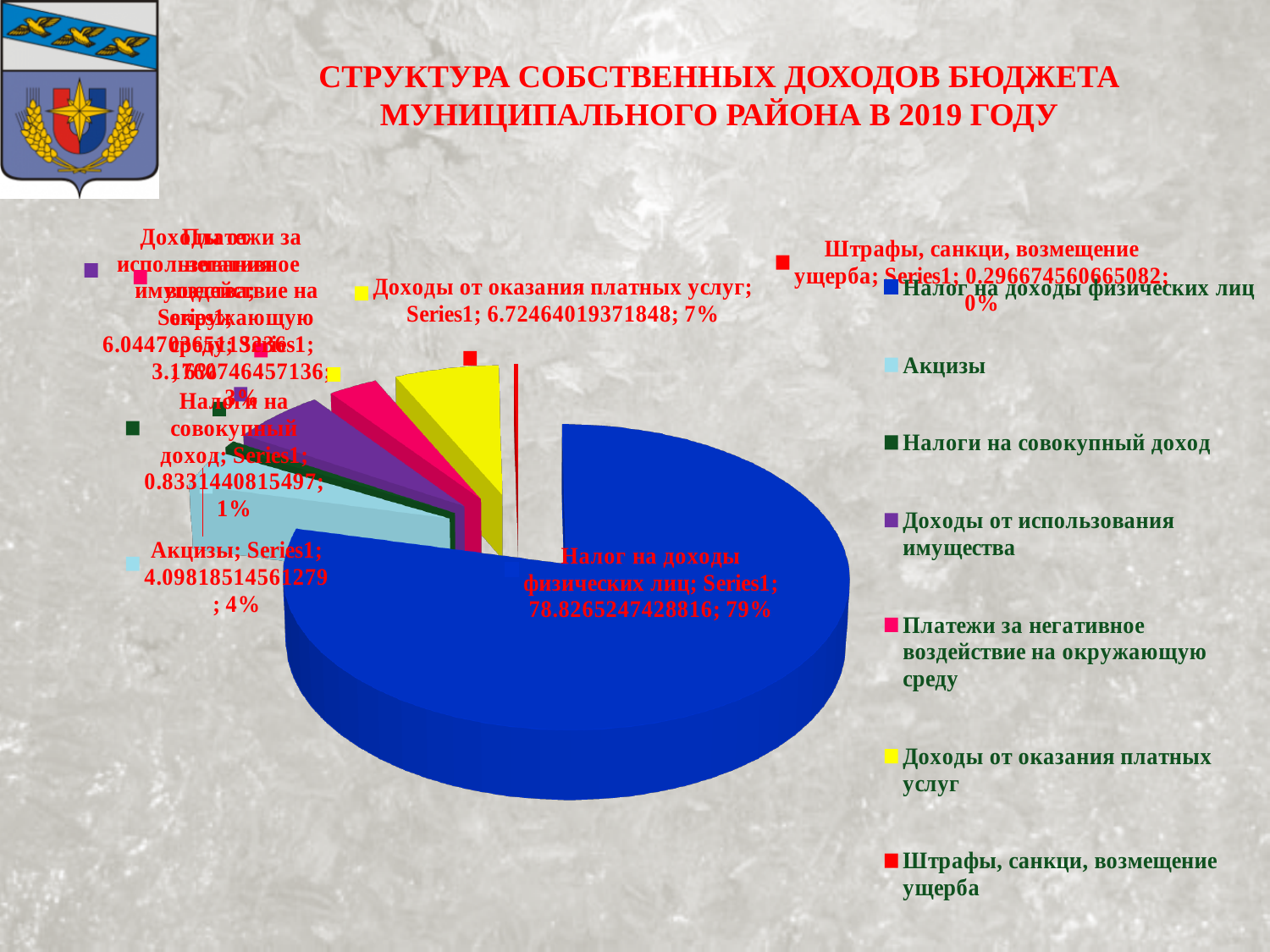
What value is printed for Налог на доходы физических лиц? 78.8265247428816 Which is larger, the share for Доходы от оказания платных услуг or the share for Акцизы? Доходы от оказания платных услуг What value is printed for Доходы от оказания платных услуг? 6.72464019371848 What percentage share does the slice for Акцизы have? 4% What value is printed for Акцизы? 4.09818514561279 What is the title of the chart? СТРУКТУРА СОБСТВЕННЫХ ДОХОДОВ БЮДЖЕТА МУНИЦИПАЛЬНОГО РАЙОНА В 2019 ГОДУ What percentage share does the slice for Налог на доходы физических лиц have? 79% What percentage share does the slice for Доходы от оказания платных услуг have? 7% Which category has the largest slice of the pie? Налог на доходы физических лиц How many categories does the legend list? 7 What kind of chart is shown on the slide? pie chart